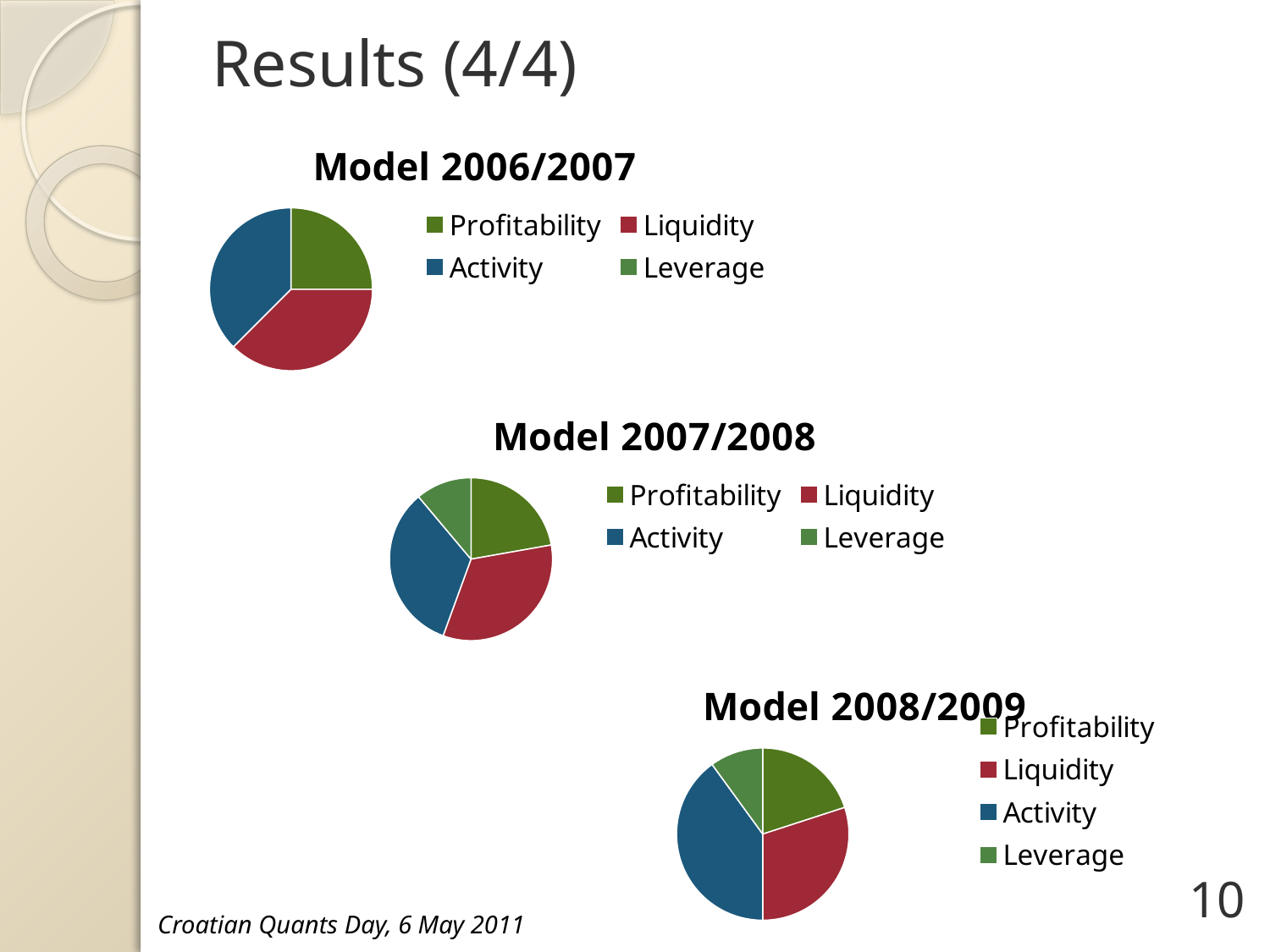
In the Model 2007/2008 chart, which slice is larger, Activity or Leverage? Activity In the Model 2008/2009 chart, which slice is larger, Liquidity or Profitability? Liquidity In the Model 2008/2009 chart, which category has the largest slice? Activity Which colour represents Activity in the pie charts? Blue In the Model 2006/2007 chart, which slice is larger, Liquidity or Profitability? Liquidity In the Model 2008/2009 chart, which category has the smallest slice? Leverage What is the title of the bottom chart on the slide? Model 2008/2009 How many pie charts are shown on the slide? 3 How many entries does the legend of the Model 2007/2008 chart list? 4 What kind of chart is used for Model 2006/2007? Pie chart In the Model 2007/2008 chart, which category has the smallest slice? Leverage